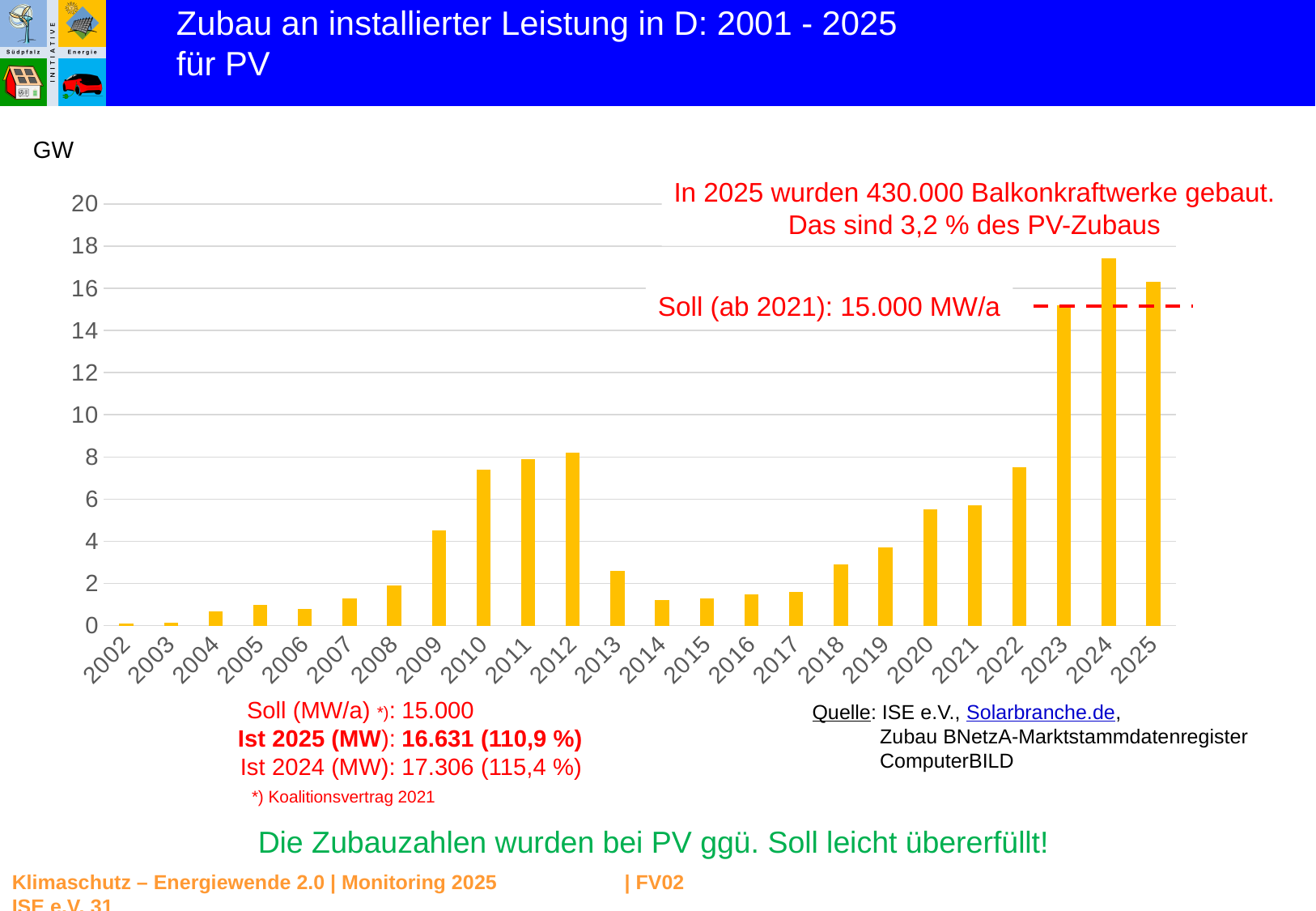
What target value (Soll) is marked by the dashed red line on the chart? 15.000 MW/a What kind of chart is shown on the slide? bar chart Is the value for 2023 greater or less than 14? greater Which year has the larger bar, 2010 or 2020? 2010 What unit is shown on the vertical axis of the chart? GW Is the value for 2017 greater or less than 2? less How many years (bars) are plotted on the chart? 24 Is the value for 2022 greater or less than 6? greater Which year has the highest PV-Zubau bar? 2024 Do the bars rise or fall from 2013 to 2024? rise